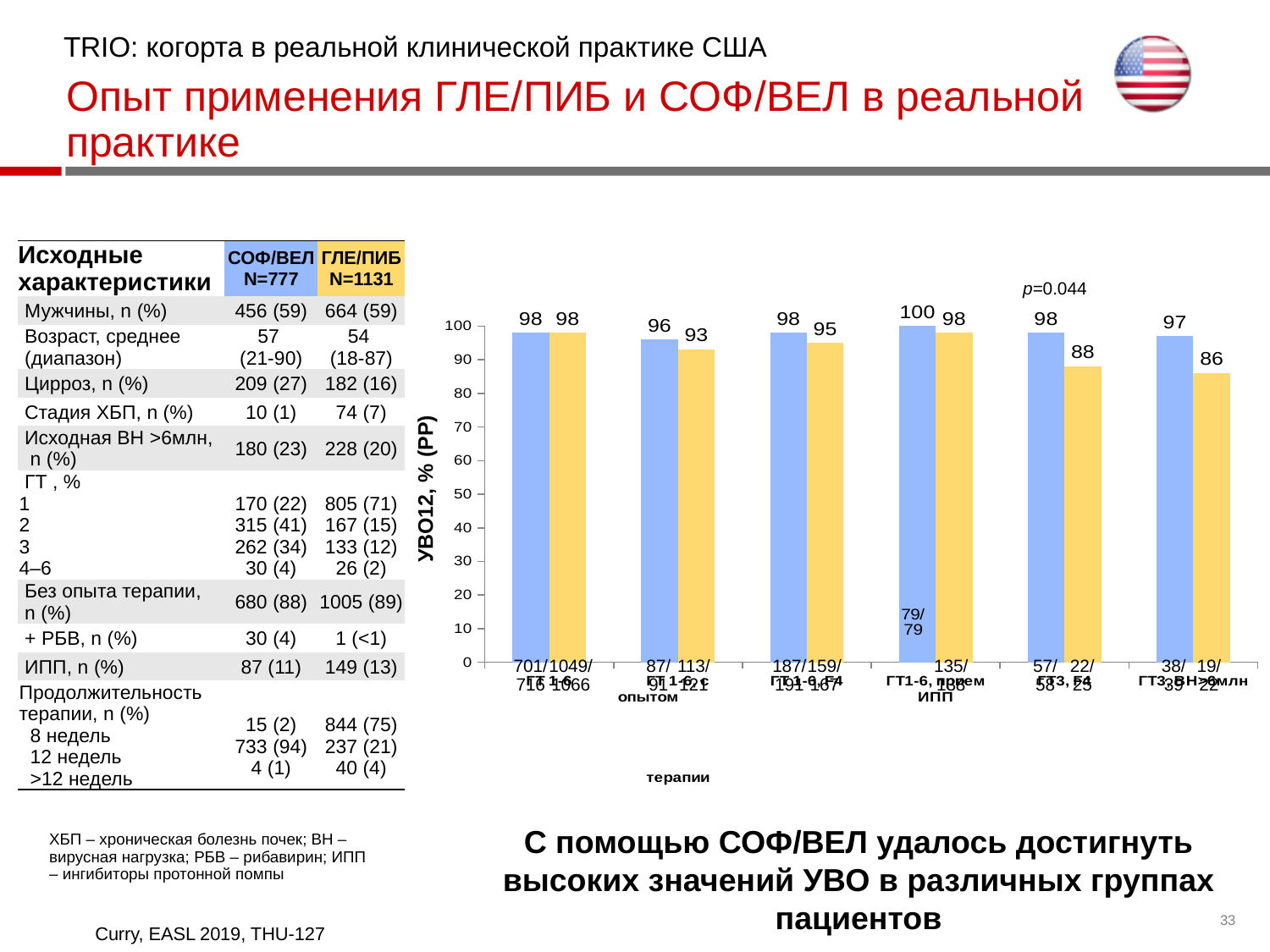
What is the value of the yellow bar in the group labelled ГТ3, F4? 88 Which group has the lowest yellow bar value? ГТ3, ВН>6млн What is the value of the yellow bar in the group labelled ГТ1-6, прием ИПП? 98 What kind of chart is shown on the right side of the slide? bar chart How many groups of bars (categories) are plotted on the chart? 6 What is the label of the vertical axis of the chart? УВО12, % (PP) What is the value of the blue bar in the group labelled ГТ1-6, прием ИПП? 100 What is the value of the yellow bar in the group labelled ГТ3, ВН>6млн? 86 Which group has the highest blue bar value? ГТ1-6, прием ИПП What is the difference between the blue and yellow bars in the group labelled ГТ3, ВН>6млн? 11 What is the value of the blue bar in the group labelled ГТ3, ВН>6млн? 97 In the group labelled ГТ3, F4, which bar is larger, the blue or the yellow? blue